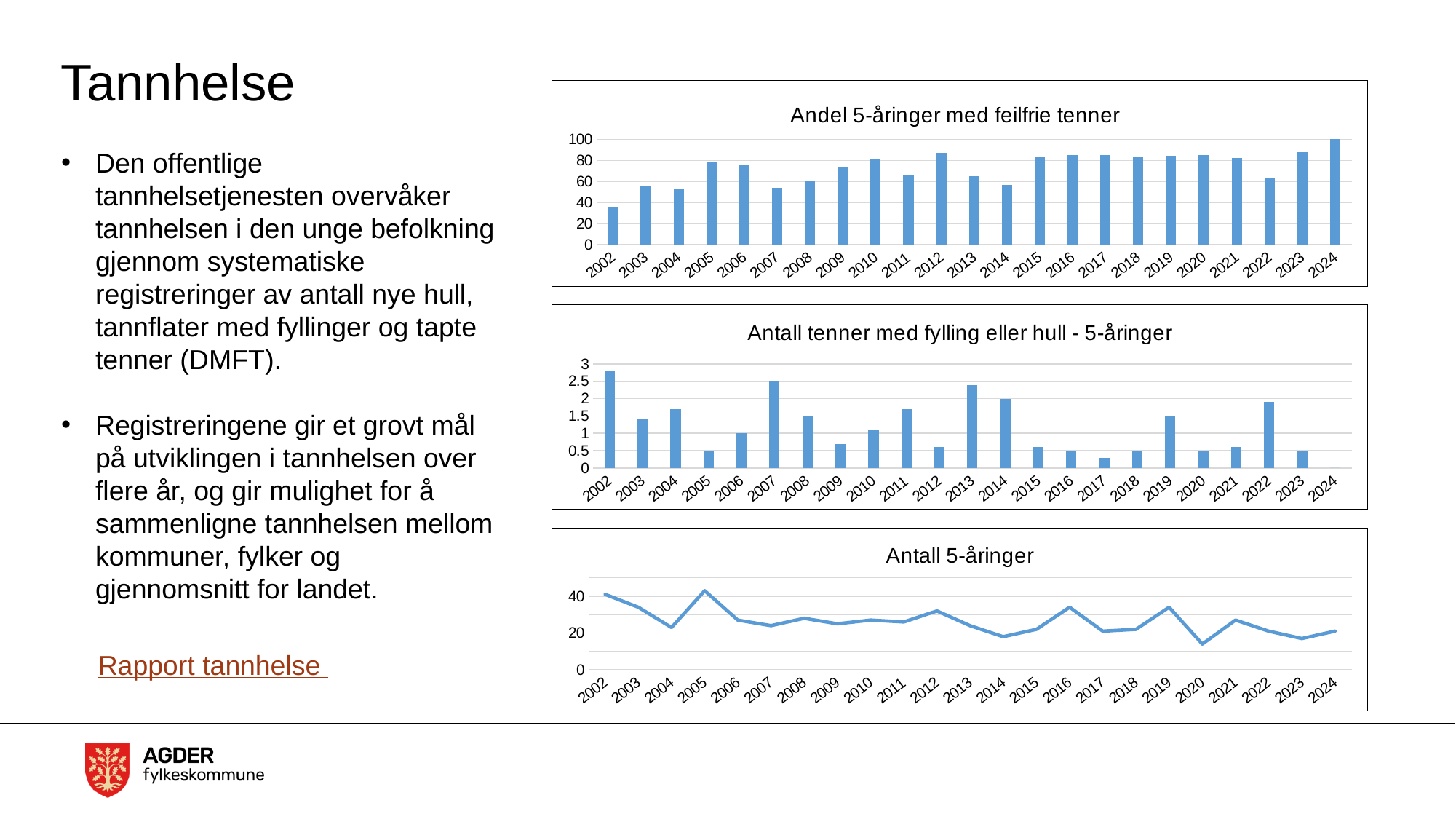
In the middle chart 'Antall tenner med fylling eller hull - 5-åringer', is the value for 2013 greater or less than 2? greater In the top chart 'Andel 5-åringer med feilfrie tenner', which year has the highest value? 2024 In the middle chart 'Antall tenner med fylling eller hull - 5-åringer', which is larger, the value for 2007 or the value for 2008? 2007 In the top chart 'Andel 5-åringer med feilfrie tenner', is the value for 2002 greater or less than 40? less In the top chart 'Andel 5-åringer med feilfrie tenner', how many years are shown on the x axis? 23 In the bottom chart 'Antall 5-åringer', which year has the lowest value? 2020 In the middle chart 'Antall tenner med fylling eller hull - 5-åringer', which year has the highest value? 2002 In the top chart 'Andel 5-åringer med feilfrie tenner', which year has the lowest value? 2002 What kind of chart is the top chart, 'Andel 5-åringer med feilfrie tenner'? bar chart In the middle chart 'Antall tenner med fylling eller hull - 5-åringer', which year has the lowest value? 2024 In the bottom chart 'Antall 5-åringer', which year has the highest value? 2005 What kind of chart is the bottom chart, 'Antall 5-åringer'? line chart